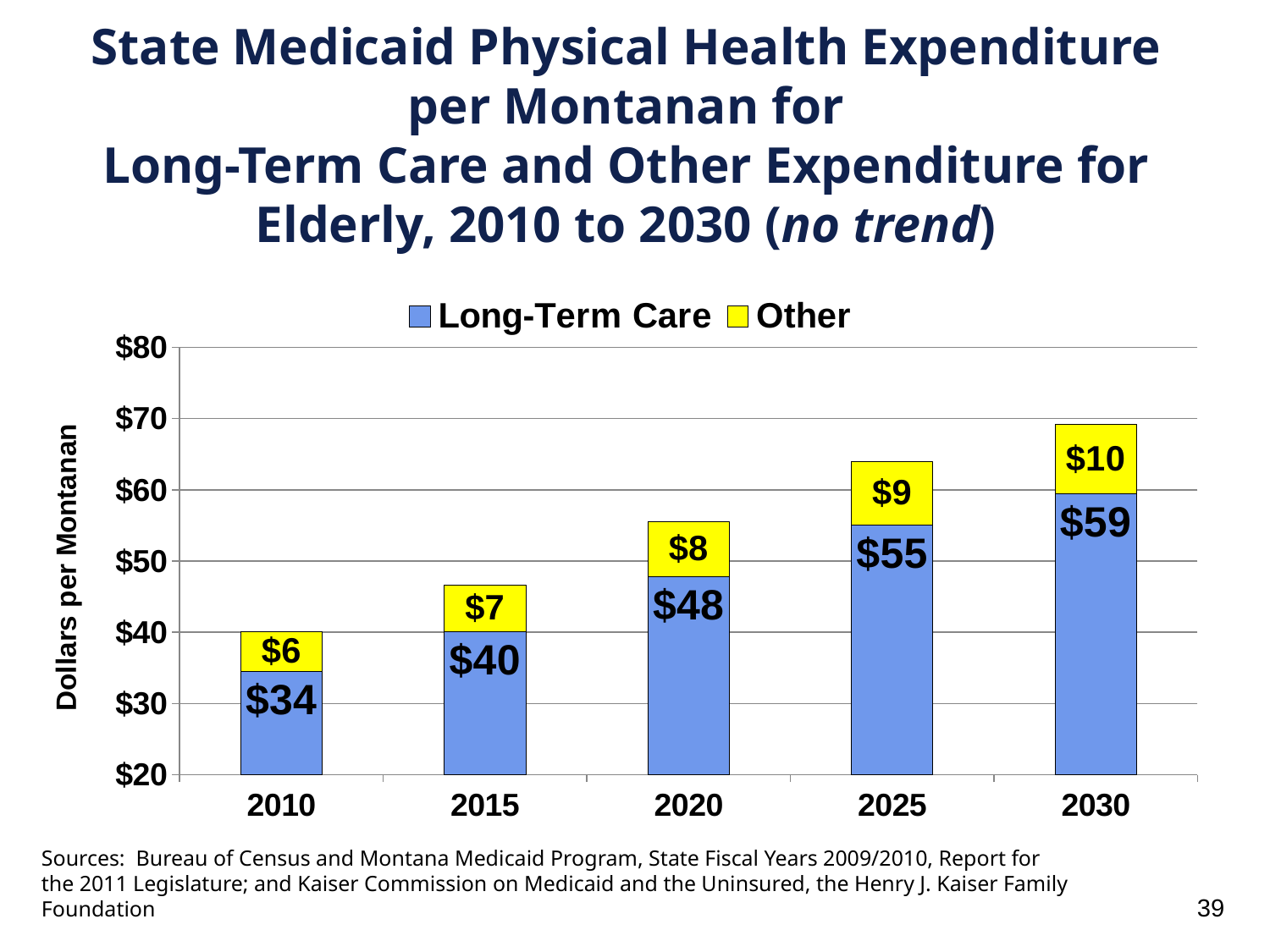
What is the Long-Term Care value for 2010? $34 What is the total of the stacked bar for 2030? $69 Do the Long-Term Care values rise or fall from 2010 to 2030? Rise Which year has the highest Long-Term Care value? 2030 What is the Other value for 2025? $9 How many series does the legend list? 2 Which is larger, the Long-Term Care value for 2015 or for 2025? 2025 What is the difference between the Long-Term Care values for 2030 and 2010? $25 What is the Long-Term Care value for 2020? $48 How many years are shown on the x axis? 5 What kind of chart is shown? Stacked bar chart Which year has the lowest Other value? 2010